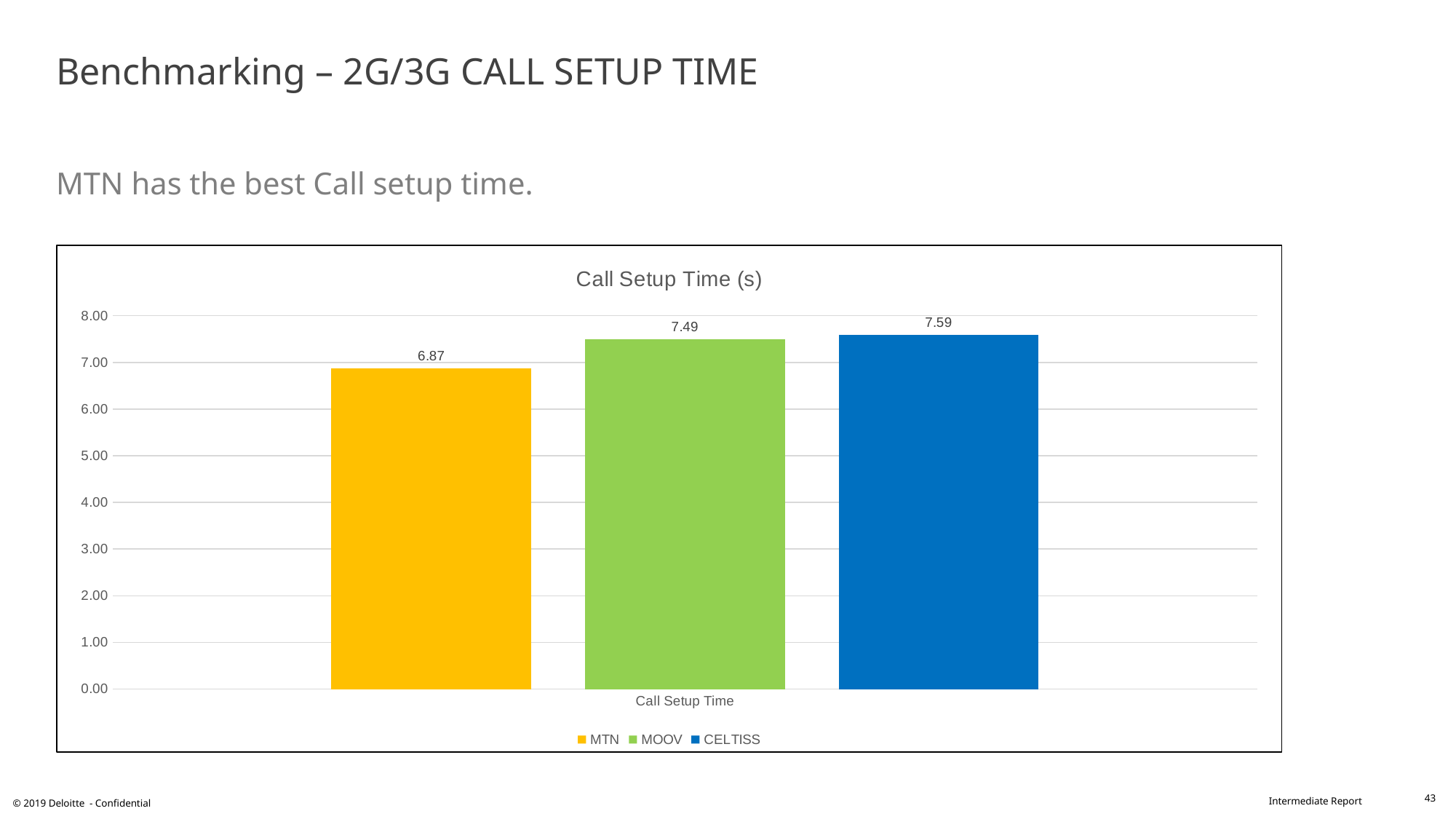
What is the call setup time for MOOV? 7.49 What is the call setup time for CELTISS? 7.59 Which has a larger call setup time, MTN or MOOV? MOOV Which operator has the highest call setup time? CELTISS Is the call setup time for MTN greater or less than 7.00? less What is the difference between the call setup times of CELTISS and MTN? 0.72 How many series does the legend list? 3 What kind of chart is shown on the slide? bar chart What is the title of the chart? Call Setup Time (s) Which operator has the lowest call setup time? MTN What is the difference between the call setup times of MOOV and MTN? 0.62 What is the call setup time for MTN? 6.87